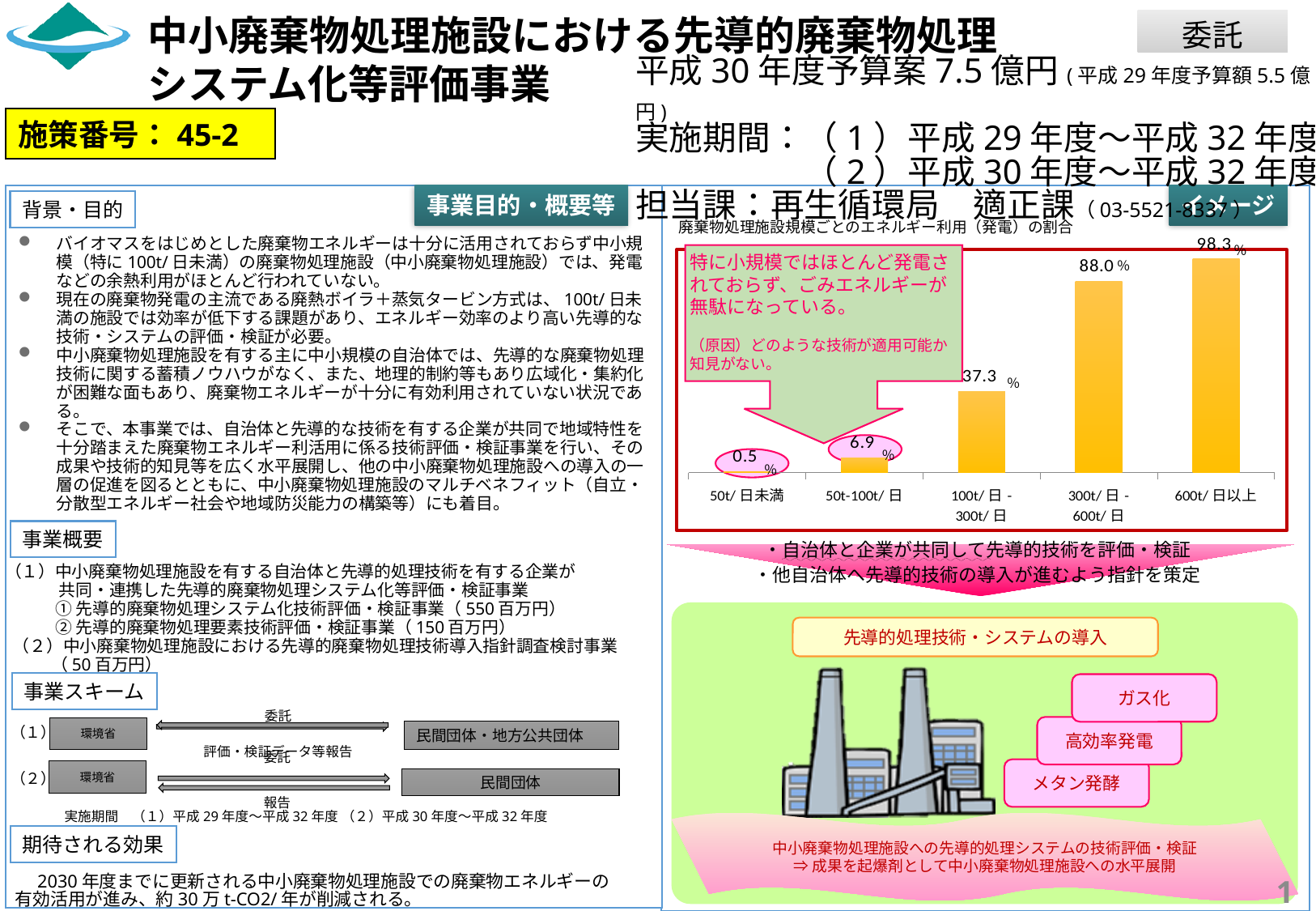
What type of chart is shown on the slide? bar chart What is the value for 50t/日未満 in the chart? 0.5% How many categories are plotted in the chart? 5 Which category has the lowest value in the chart? 50t/日未満 What is the value for 100t/日-300t/日 in the chart? 37.3% Do the values rise or fall as the facility size increases along the x axis? rise Which category has the highest value in the chart? 600t/日以上 What is the difference between the values for 600t/日以上 and 300t/日-600t/日? 10.3% What is the value for 300t/日-600t/日 in the chart? 88.0% What is the value for 50t-100t/日 in the chart? 6.9% What is the title of the chart on the slide? 廃棄物処理施設規模ごとのエネルギー利用（発電）の割合 What is the value for 600t/日以上 in the chart? 98.3%